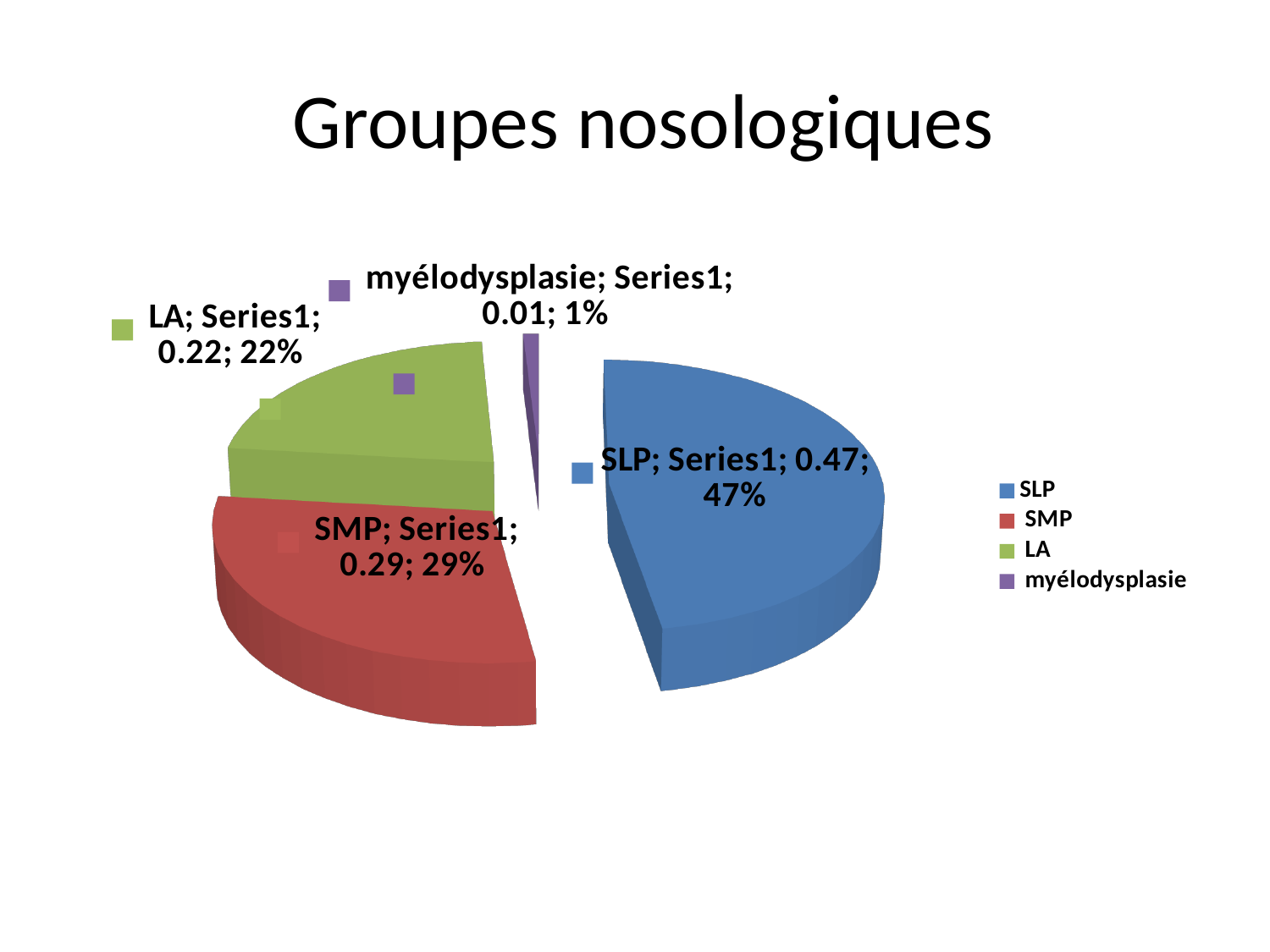
What percentage share does the myélodysplasie slice have? 1% What percentage share does the LA slice have? 22% What percentage share does the SMP slice have? 29% Which category has the smallest slice? myélodysplasie Which category has the largest slice? SLP What kind of chart is shown on the slide? pie chart What value is printed for the SLP slice? 0.47 Which slice is larger, SMP or LA? SMP How many categories does the pie chart have? 4 What is the difference in percentage points between the SLP and SMP slices? 18% What is the title of the chart? Groupes nosologiques